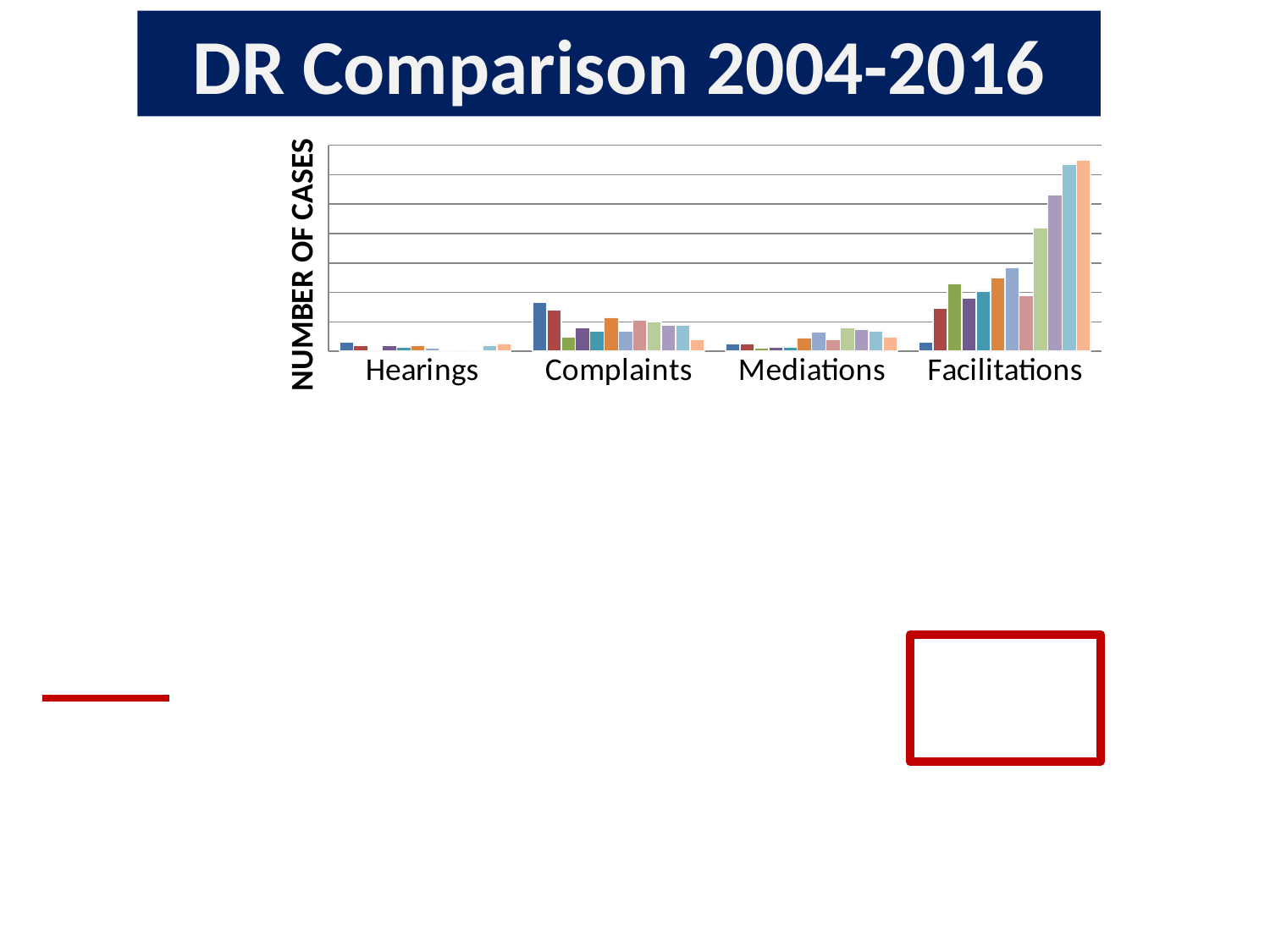
Within the Facilitations category, do the bars generally rise or fall from left to right? rise What is the title of the slide containing the chart? DR Comparison 2004-2016 Is the tallest bar in Facilitations taller or shorter than the tallest bar in Complaints? taller Within the Complaints category, do the bars generally rise or fall from left to right? fall How many categories are shown on the x axis of the chart? 4 What kind of chart is shown on the slide? bar chart What is the label on the vertical axis of the chart? NUMBER OF CASES Is the tallest bar in Complaints taller or shorter than the tallest bar in Mediations? taller Which category has the smallest bars overall in the chart? Hearings Which category contains the tallest bar in the chart? Facilitations